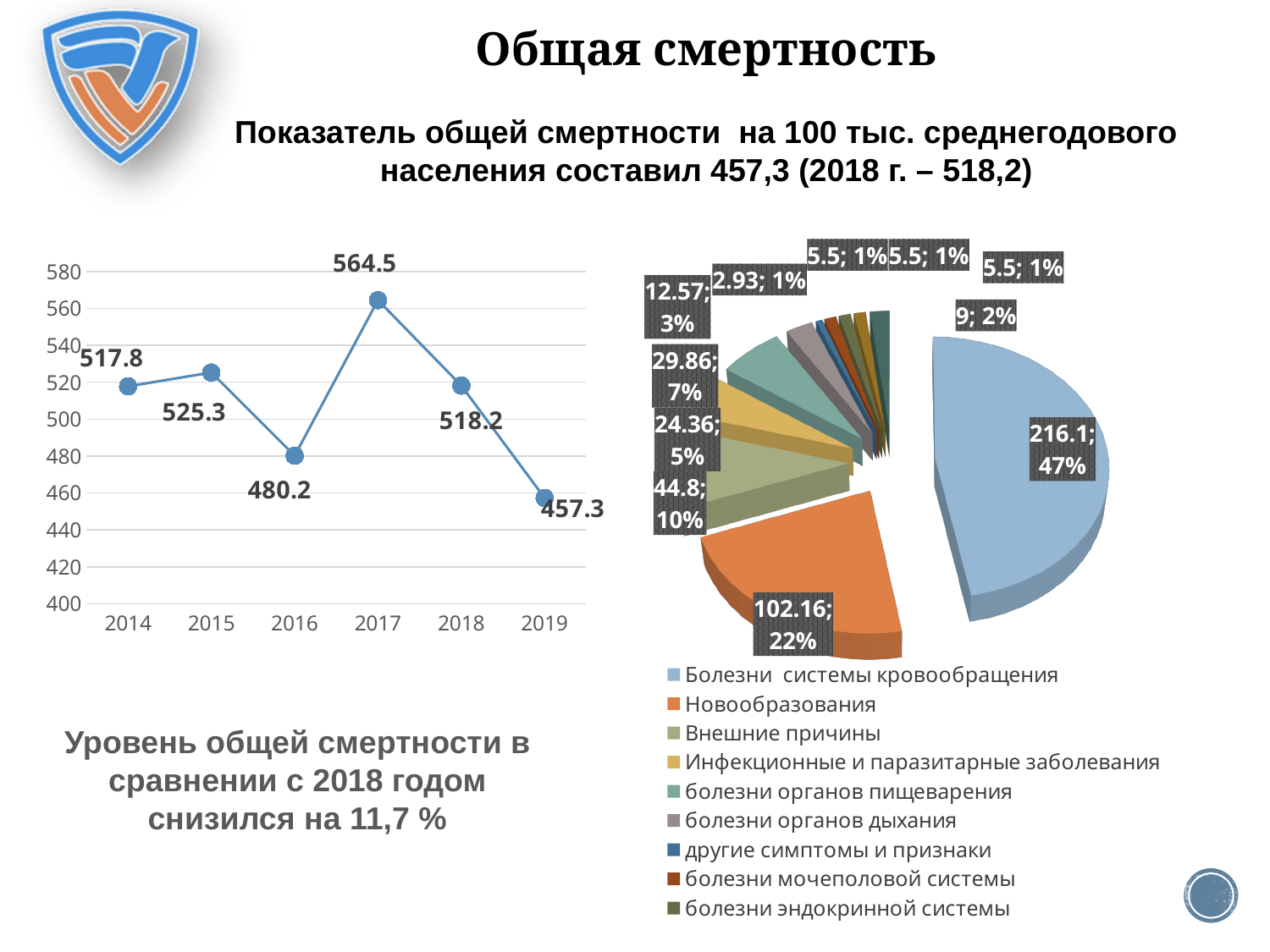
In the line chart on the left, do the values rise or fall from 2017 to 2019? fall In the line chart on the left, which year has the highest value? 2017 In the line chart on the left, what is the value for 2017? 564.5 In the line chart on the left, what is the value for 2016? 480.2 In the line chart on the left, what is the difference between the values for 2018 and 2019? 60.9 What kind of chart is the chart on the left showing values for 2014 to 2019? line chart In the pie chart on the right, what is the value for Новообразования? 102.16 How many entries does the legend of the pie chart on the right list? 9 How many years are plotted in the line chart on the left? 6 In the line chart on the left, which year has the larger value, 2014 or 2015? 2015 In the line chart on the left, which year has the lowest value? 2019 In the pie chart on the right, what share does the largest slice (Болезни системы кровообращения) have? 47%